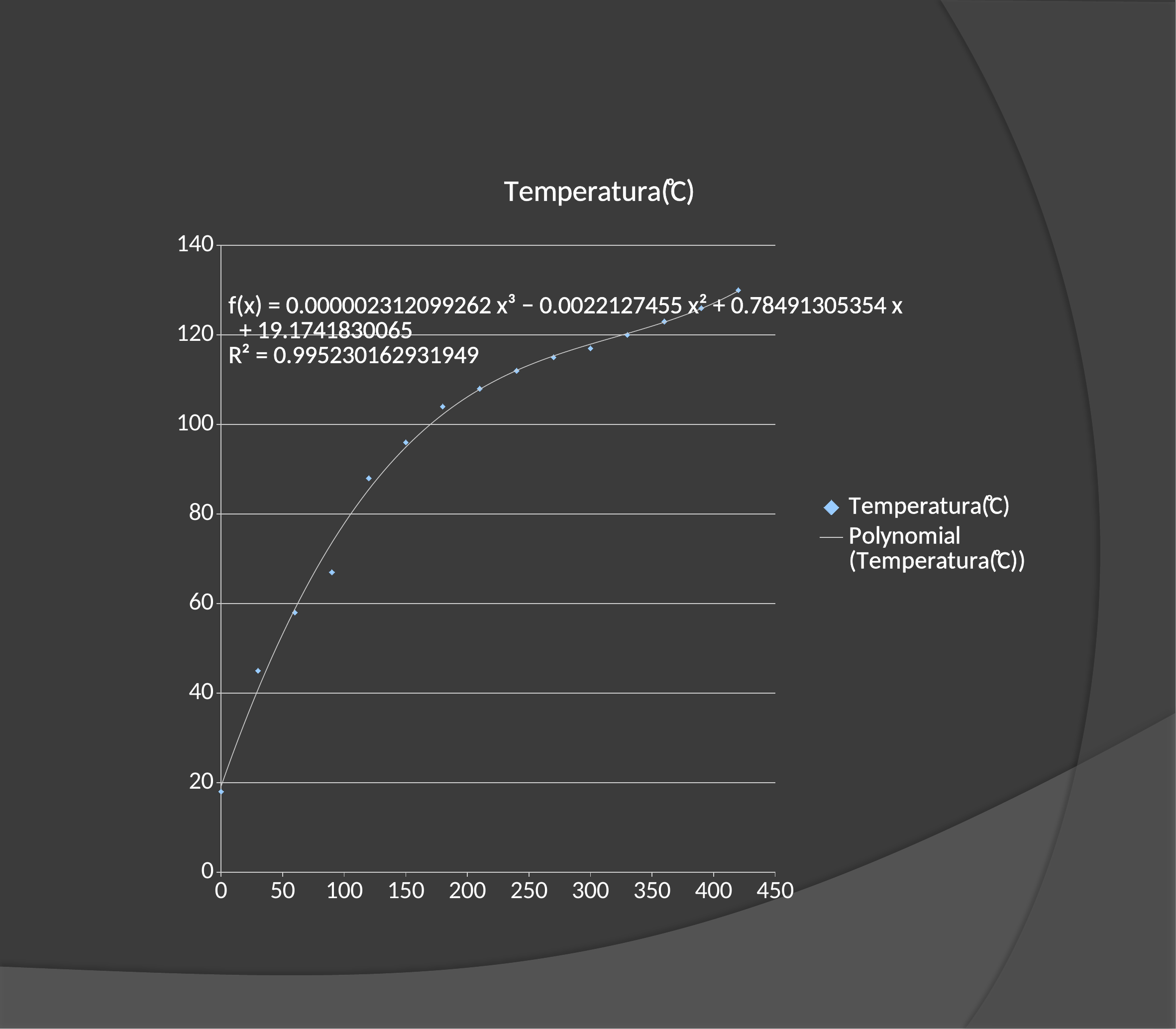
Is the Temperatura(℃) value at x = 420 greater or less than 120? greater What kind of chart is shown on the slide? scatter chart Is the Temperatura(℃) value at x = 30 greater or less than 40? greater What R² value is shown for the polynomial trendline? 0.995230162931949 Do the Temperatura(℃) values rise or fall as x increases along the x axis? rise How many data points are plotted in the Temperatura(℃) series? 15 How many entries does the chart legend list? 2 At which x value is the Temperatura(℃) point lowest? 0 At which x value is the Temperatura(℃) point highest? 420 Is the Temperatura(℃) value at x = 240 greater or less than 100? greater What is the title of the chart? Temperatura(℃)